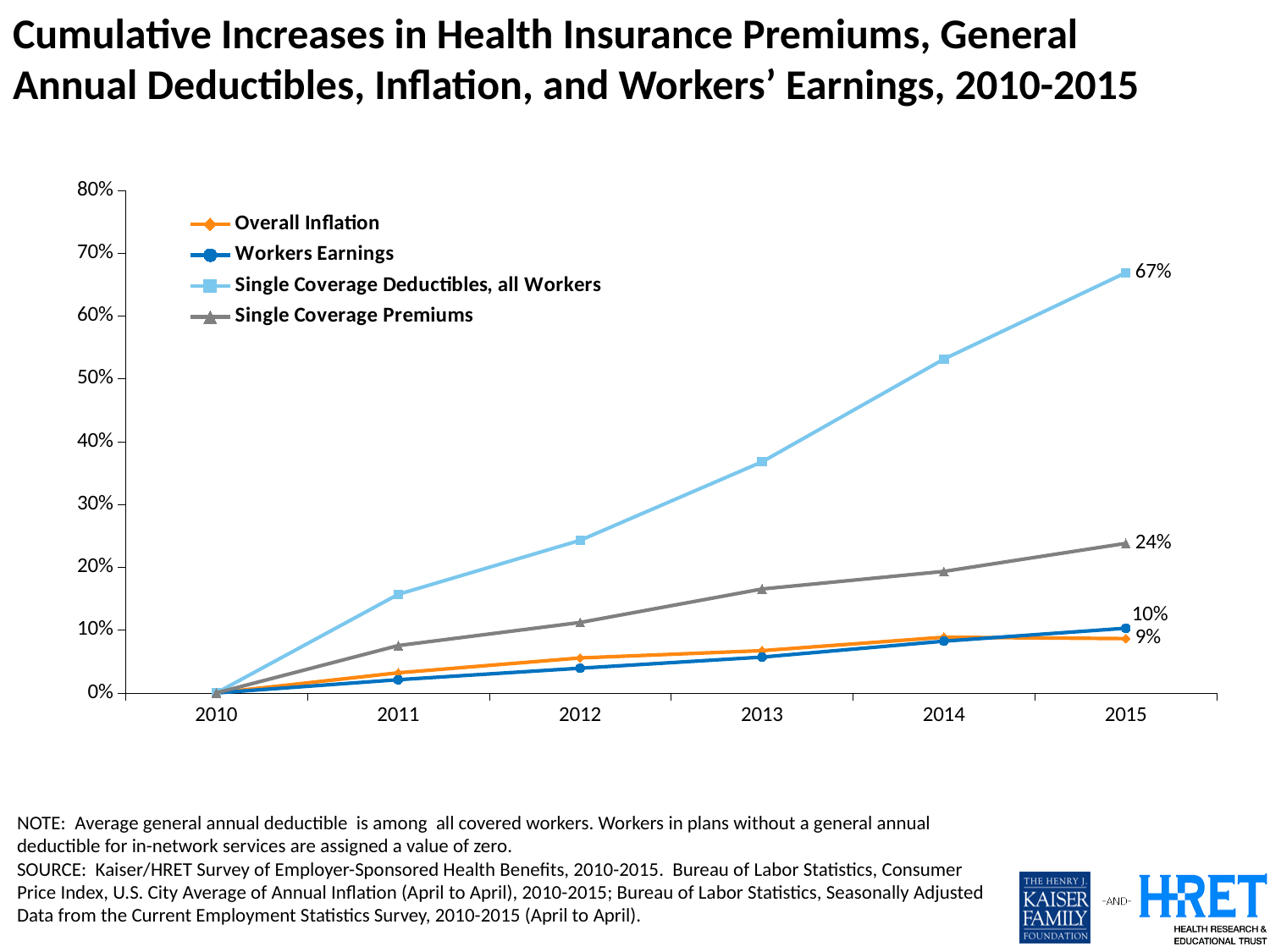
What is the difference between the 2015 values for Single Coverage Deductibles, all Workers and Single Coverage Premiums? 43% Is the value for Single Coverage Deductibles, all Workers in 2014 greater or less than 50%? greater How many series does the legend list? 4 What is the cumulative increase for Single Coverage Deductibles, all Workers in 2015? 67% What is the cumulative increase for Overall Inflation in 2015? 9% What type of chart is shown on the slide? line chart What is the cumulative increase for Single Coverage Premiums in 2015? 24% Which series has the lowest value in 2015? Overall Inflation Does the Single Coverage Premiums line rise or fall from 2010 to 2015? rise How many years are shown on the x axis? 6 Which series has the highest value in 2015? Single Coverage Deductibles, all Workers What is the cumulative increase for Workers Earnings in 2015? 10%